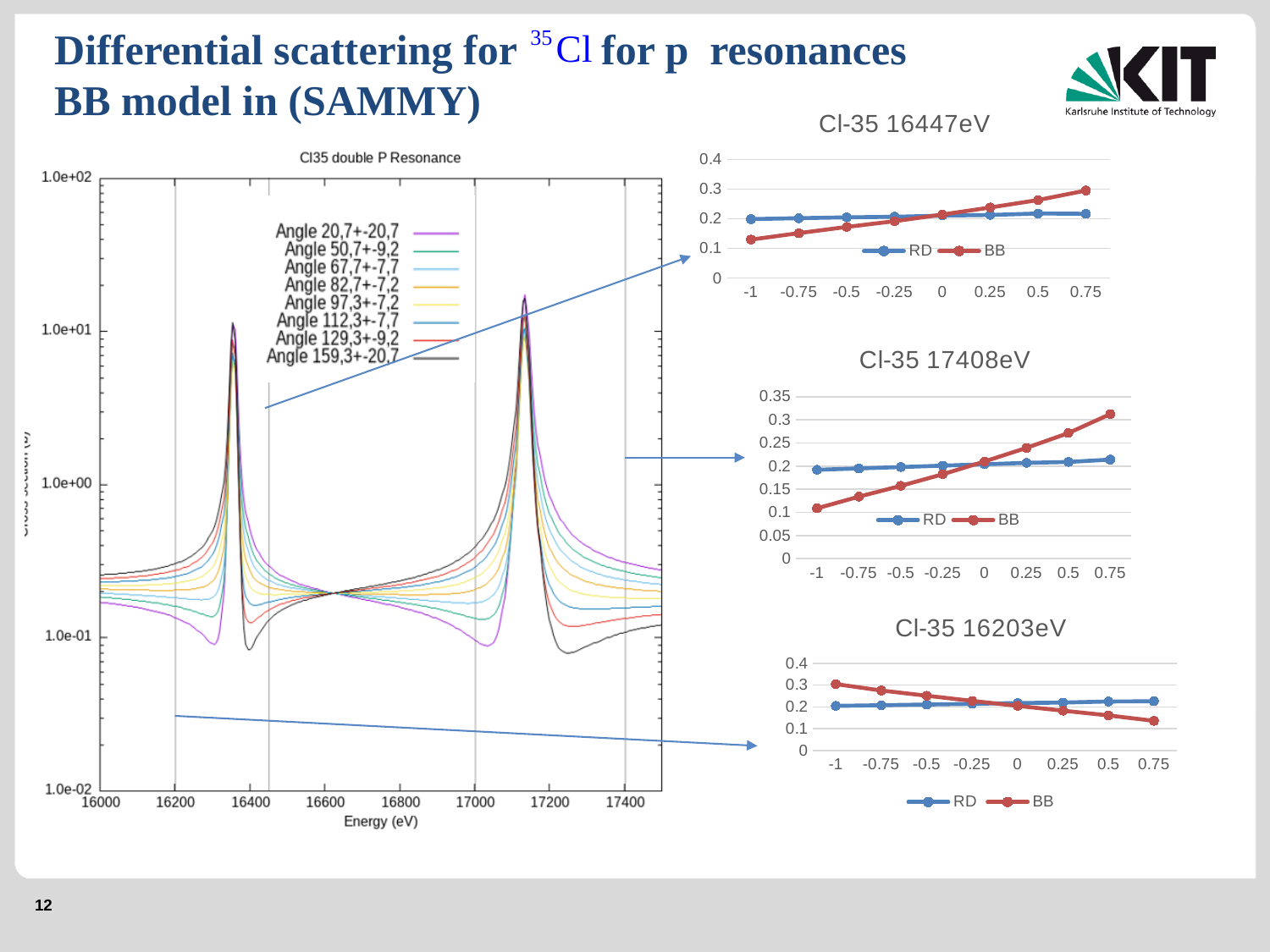
In the "Cl-35 16447eV" chart, is the BB value at x = 0.75 greater or less than 0.2? greater In the "Cl-35 16203eV" chart, is the BB value at x = 0.75 greater or less than 0.2? less In the large "Cl35 double P Resonance" chart, how many angle series does the legend list? 8 What kind of chart is the "Cl-35 16447eV" chart? line chart In the "Cl-35 17408eV" chart, is the BB value at x = -1 greater or less than 0.15? less In the "Cl-35 16447eV" chart, does the BB series rise or fall from x = -1 to x = 0.75? rise In the "Cl-35 16447eV" chart, how many series does the legend list? 2 In the "Cl-35 16203eV" chart, which series has the larger value at x = -1, RD or BB? BB In the "Cl-35 17408eV" chart, how many points are plotted along the x axis for each series? 8 In the "Cl-35 16203eV" chart, does the BB series rise or fall from x = -1 to x = 0.75? fall In the "Cl-35 17408eV" chart, which series has the larger value at x = 0.75, RD or BB? BB What is the title of the large chart on the left of the slide? Cl35 double P Resonance